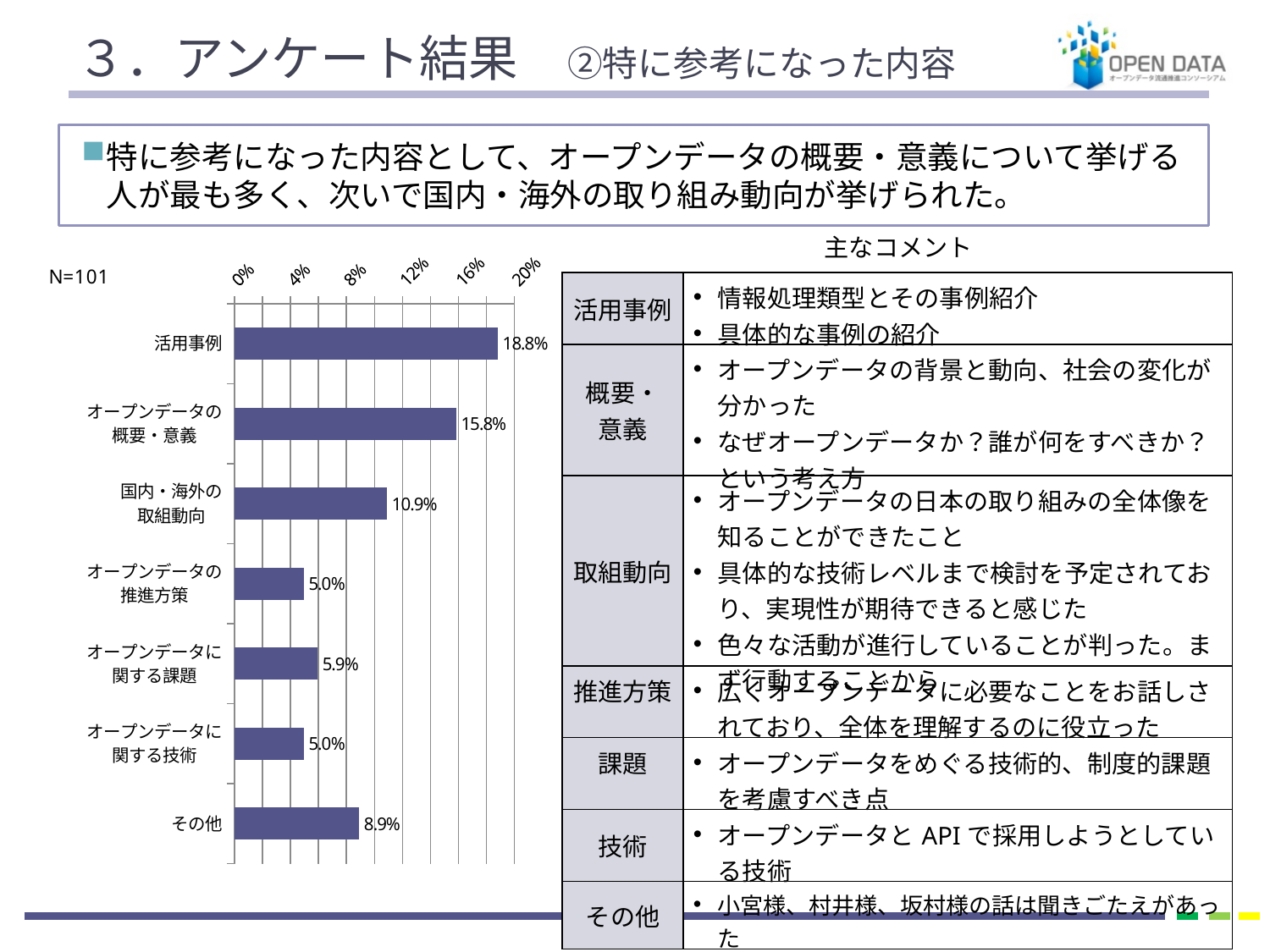
Is the value for 国内・海外の取組動向 greater or less than 12%? less Which is larger, the value for その他 or the value for オープンデータに関する課題? その他 How many categories are shown in the bar chart? 7 What is the value for オープンデータに関する課題? 5.9% What is the value for その他? 8.9% Which category has the highest value? 活用事例 What is the value for 活用事例? 18.8% What is the value for オープンデータの概要・意義? 15.8% What is the difference between the values for 活用事例 and オープンデータの概要・意義? 3.0% What kind of chart is shown on the slide? bar chart What is the value for 国内・海外の取組動向? 10.9% What is the sample size (N) shown next to the chart? N=101